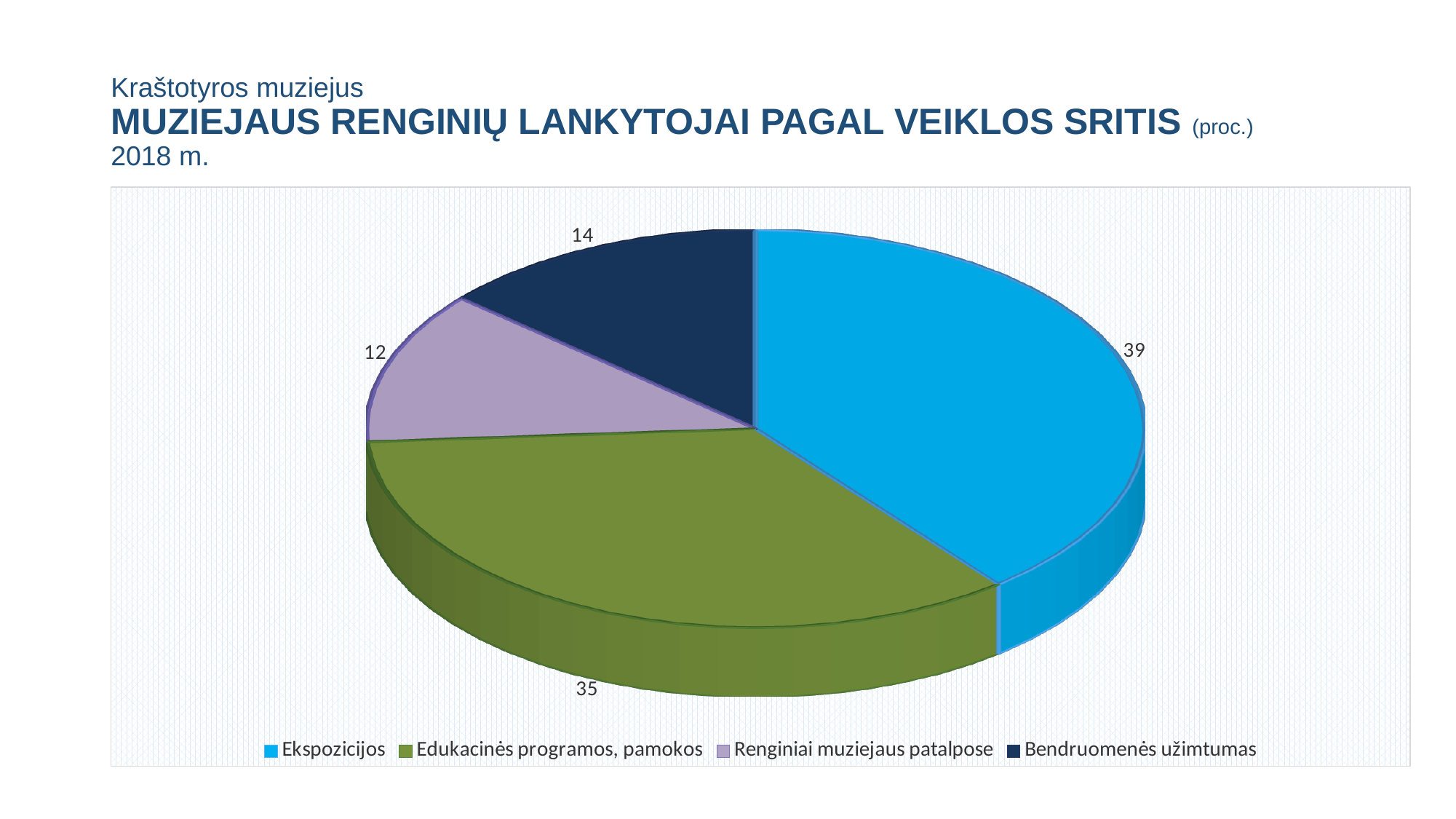
Which year does the chart title refer to? 2018 m. Which is larger, Bendruomenės užimtumas or Renginiai muziejaus patalpose? Bendruomenės užimtumas How many slices does the pie chart have? 4 What is the value for Renginiai muziejaus patalpose? 12 What is the difference between the values for Ekspozicijos and Edukacinės programos, pamokos? 4 What kind of chart is shown on the slide? pie chart What is the value for Ekspozicijos? 39 Which category has the smallest slice? Renginiai muziejaus patalpose What is the value for Edukacinės programos, pamokos? 35 Which category has the largest slice? Ekspozicijos What is the value for Bendruomenės užimtumas? 14 What is the total of all the slice values shown? 100